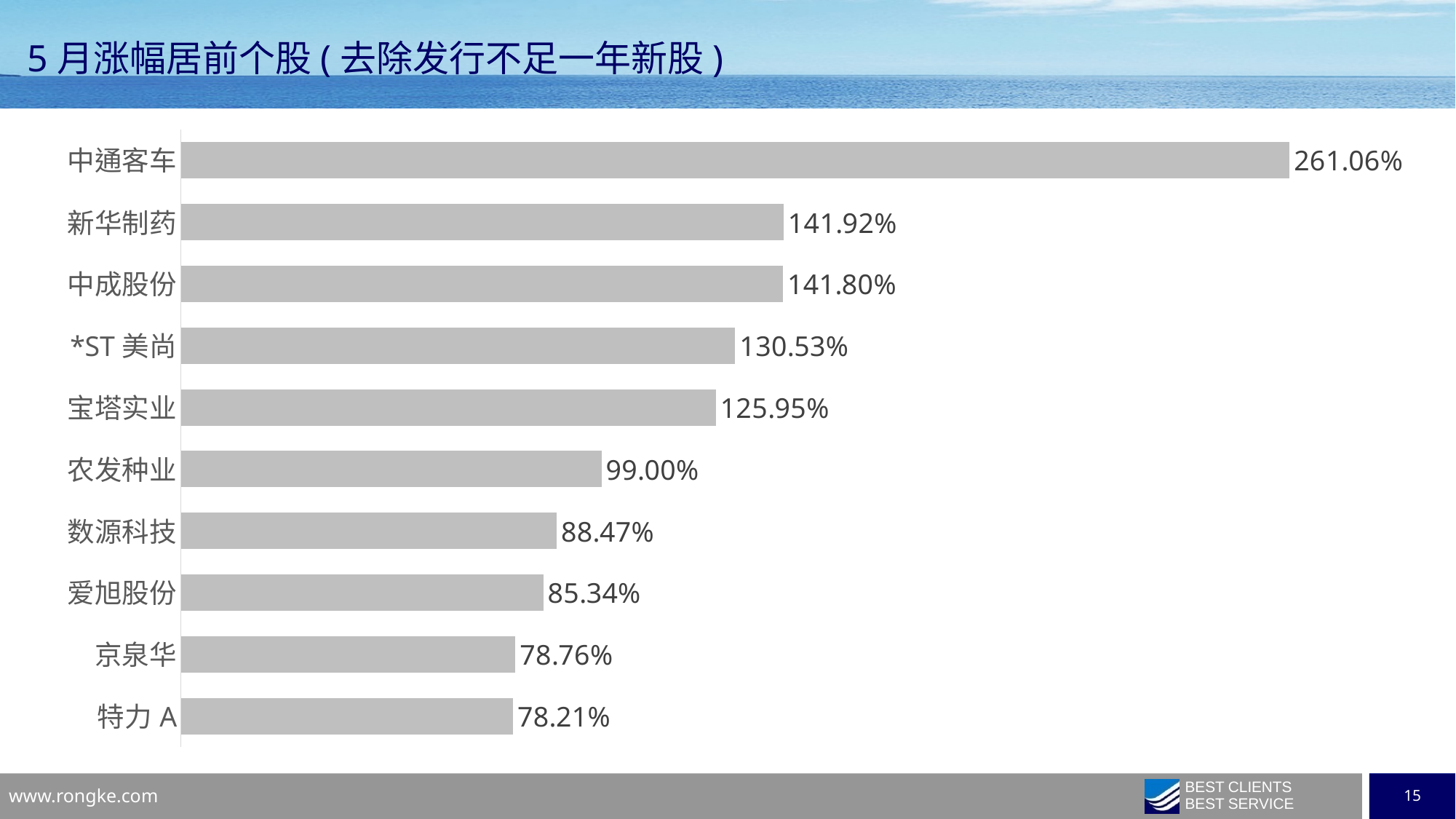
Which stock has the lowest value in the chart? 特力 A What kind of chart is shown on the slide? Bar chart What is the value shown for 中通客车? 261.06% What is the difference between the values for 中通客车 and 新华制药? 119.14% Which has a larger value, 农发种业 or 爱旭股份? 农发种业 How many stocks are shown in the chart? 10 What is the value shown for 数源科技? 88.47% What is the title of the slide? 5 月涨幅居前个股 ( 去除发行不足一年新股 ) What is the value shown for 宝塔实业? 125.95% What is the value shown for 特力 A? 78.21% What is the difference between the values for 农发种业 and 数源科技? 10.53% Which stock has the highest value in the chart? 中通客车